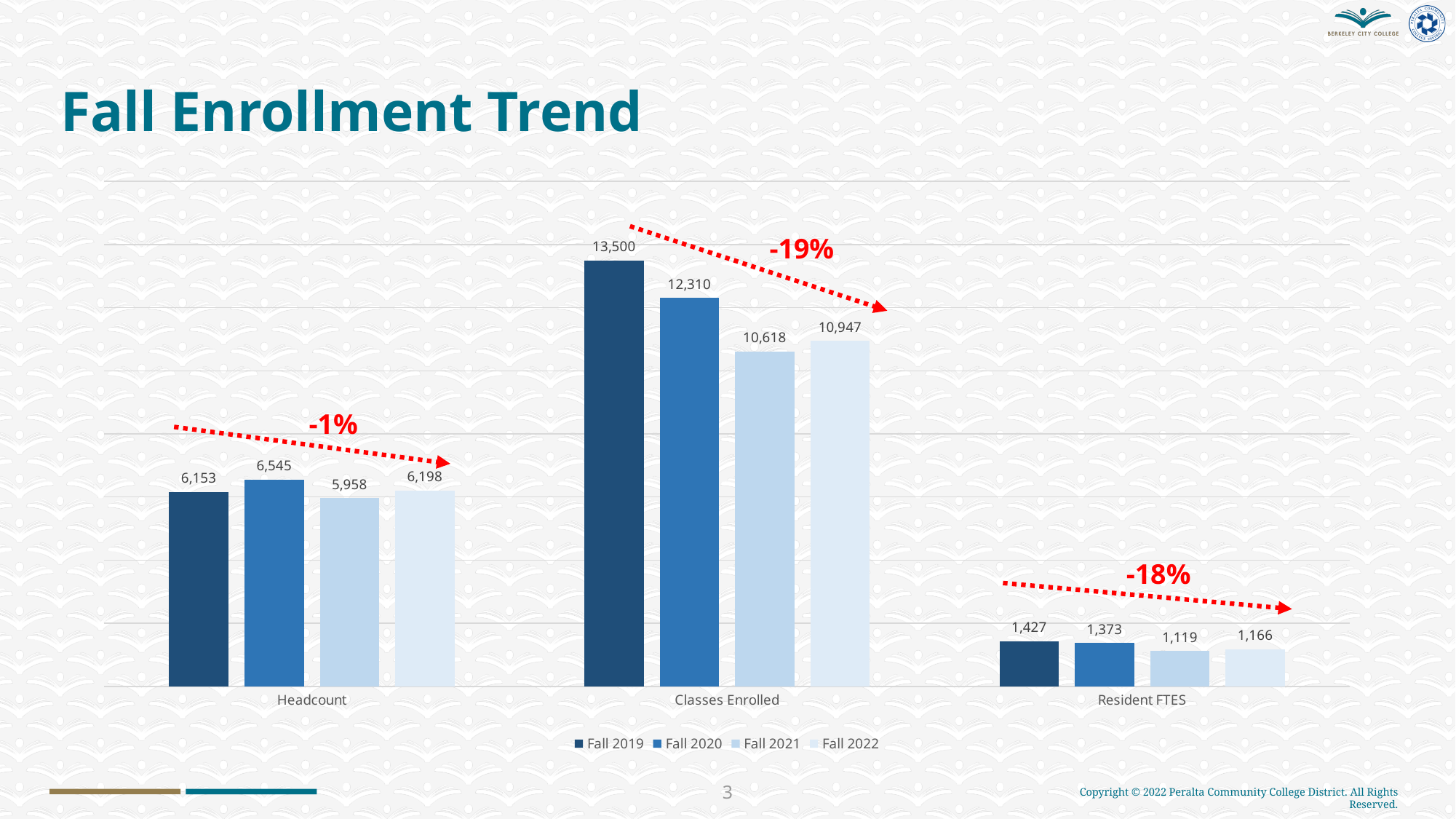
What percentage change is annotated above the Classes Enrolled bars? -19% What is the difference between the Fall 2019 and Fall 2020 Classes Enrolled values? 1,190 What is the number of Classes Enrolled for Fall 2022? 10,947 What is the Resident FTES value for Fall 2021? 1,119 How many categories are shown on the x axis? 3 Which is larger, the Fall 2020 Headcount or the Fall 2022 Headcount? Fall 2020 Headcount What is the Headcount for Fall 2019? 6,153 Which fall term has the highest Classes Enrolled value? Fall 2019 What is the title of the slide? Fall Enrollment Trend Which fall term has the lowest Headcount? Fall 2021 What kind of chart is shown on the slide? Bar chart How many series does the legend list? 4